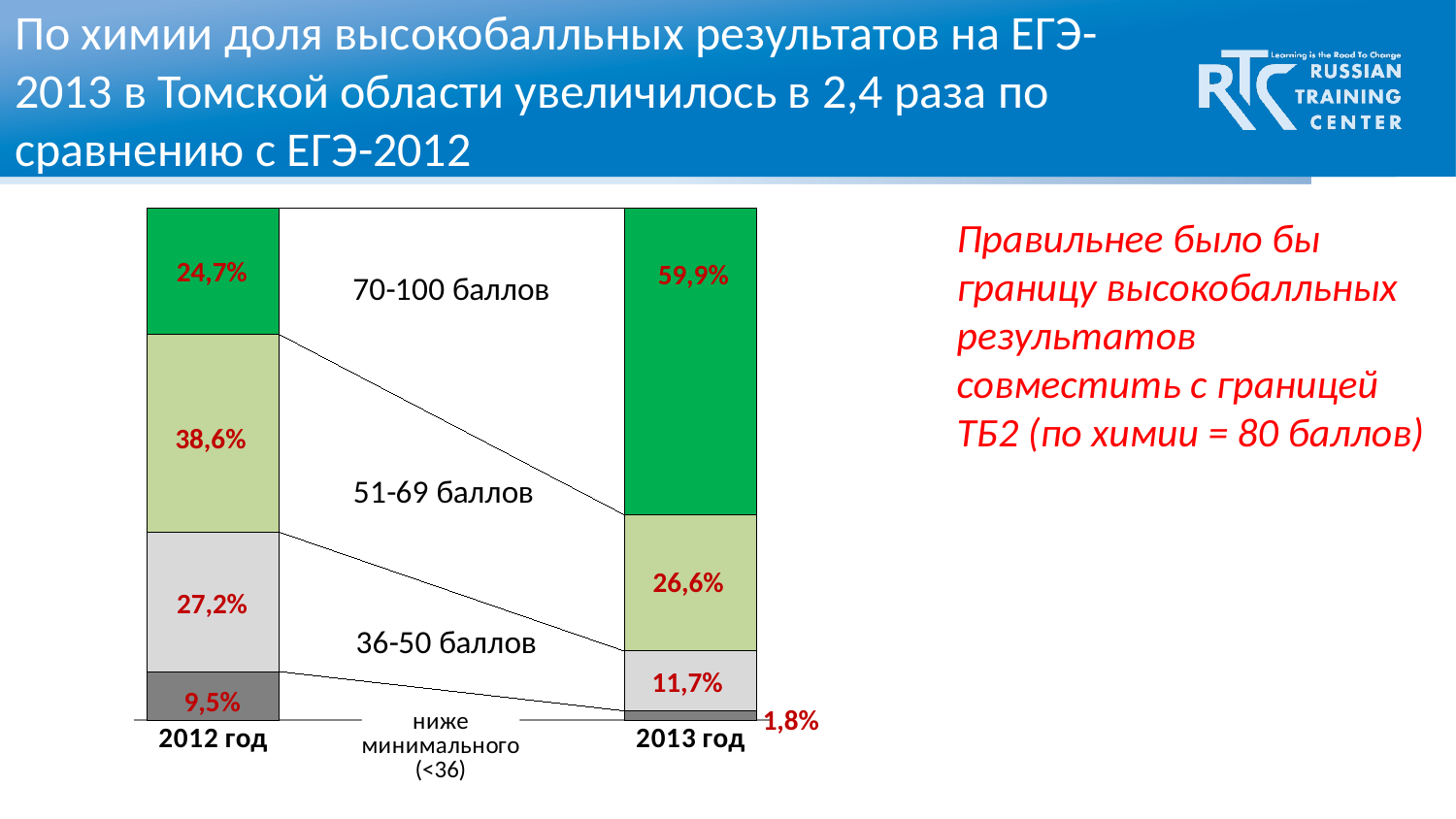
What share of 2013 год results fall in the 70-100 баллов band? 59,9% What share of 2012 год results fall in the 70-100 баллов band? 24,7% What is the value of the 51-69 баллов segment for 2013 год? 26,6% What type of chart is shown on the slide? Stacked bar chart What is the difference between the 36-50 баллов shares for 2012 год and 2013 год? 15,5 What is the total of the segments in the 2013 год bar? 100,0% Which year has the larger 51-69 баллов share, 2012 год or 2013 год? 2012 год Which score band is the largest segment in the 2013 год bar? 70-100 баллов What is the value of the ниже минимального (<36) segment for 2012 год? 9,5% Which score band is the smallest segment in the 2012 год bar? ниже минимального (<36) By how many percentage points did the 70-100 баллов share change from 2012 год to 2013 год? 35,2 How many score bands are shown in each stacked bar? 4